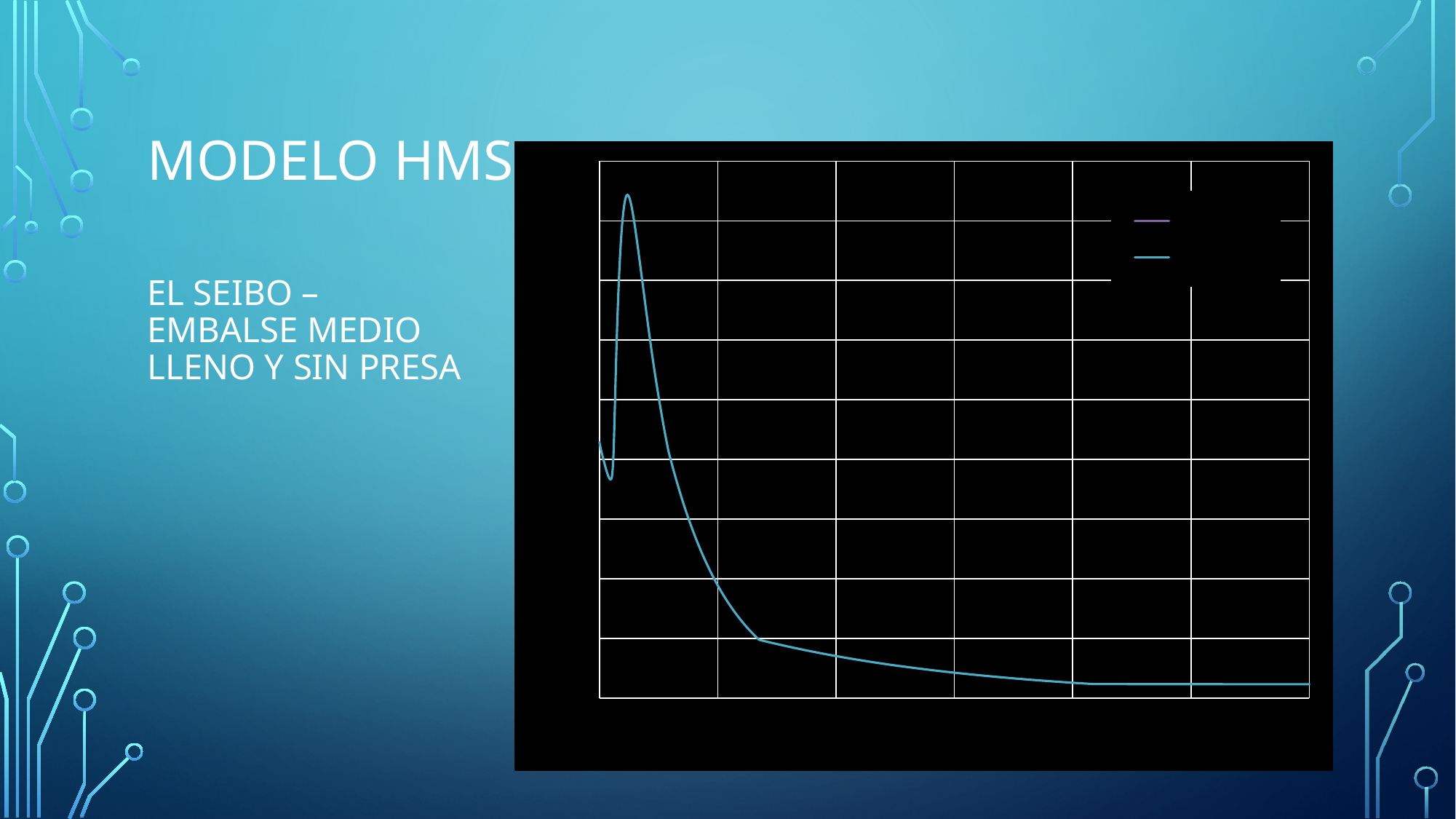
What is the background colour of the chart area? black After its peak near the left side, does the plotted line rise or fall as it moves to the right along the x axis? fall How many entries does the chart's legend show? 2 What kind of chart is shown on the slide? line chart What colour is the plotted line on the chart? light blue